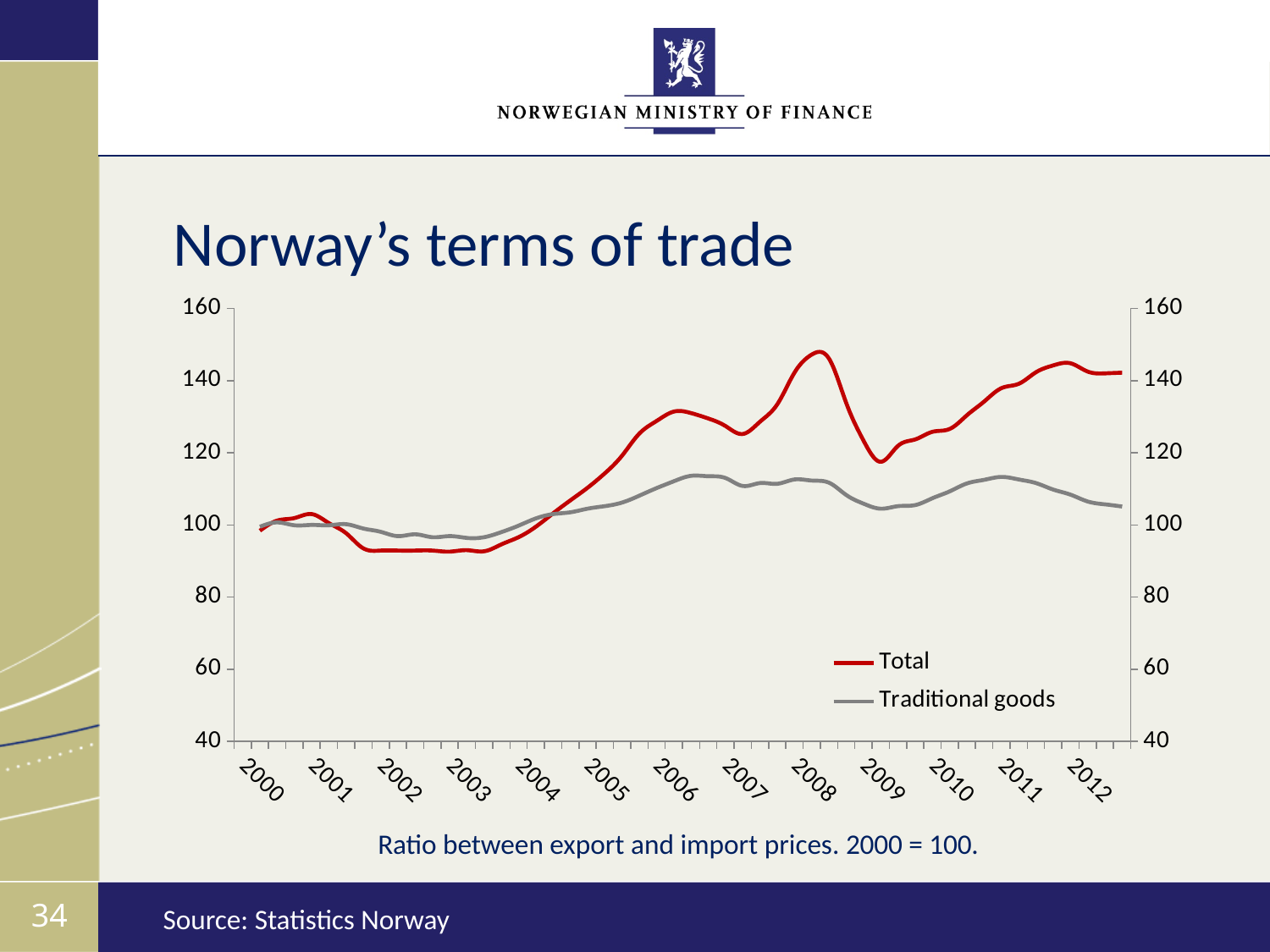
What kind of chart is shown on the slide? line chart Does the Total series rise or fall between 2003 and 2008? rise Which series has the higher value in 2002, Total or Traditional goods? Traditional goods Which series has the higher value in 2008, Total or Traditional goods? Total Is the value for Traditional goods in 2006 greater or less than 120? less How many years are labelled on the x axis? 13 How many series does the legend list? 2 What is the title of the chart? Norway's terms of trade What are the two series named in the legend? Total and Traditional goods Is the value for Total in 2002 greater or less than 100? less Is the value for Total at its 2008 peak greater or less than 140? greater